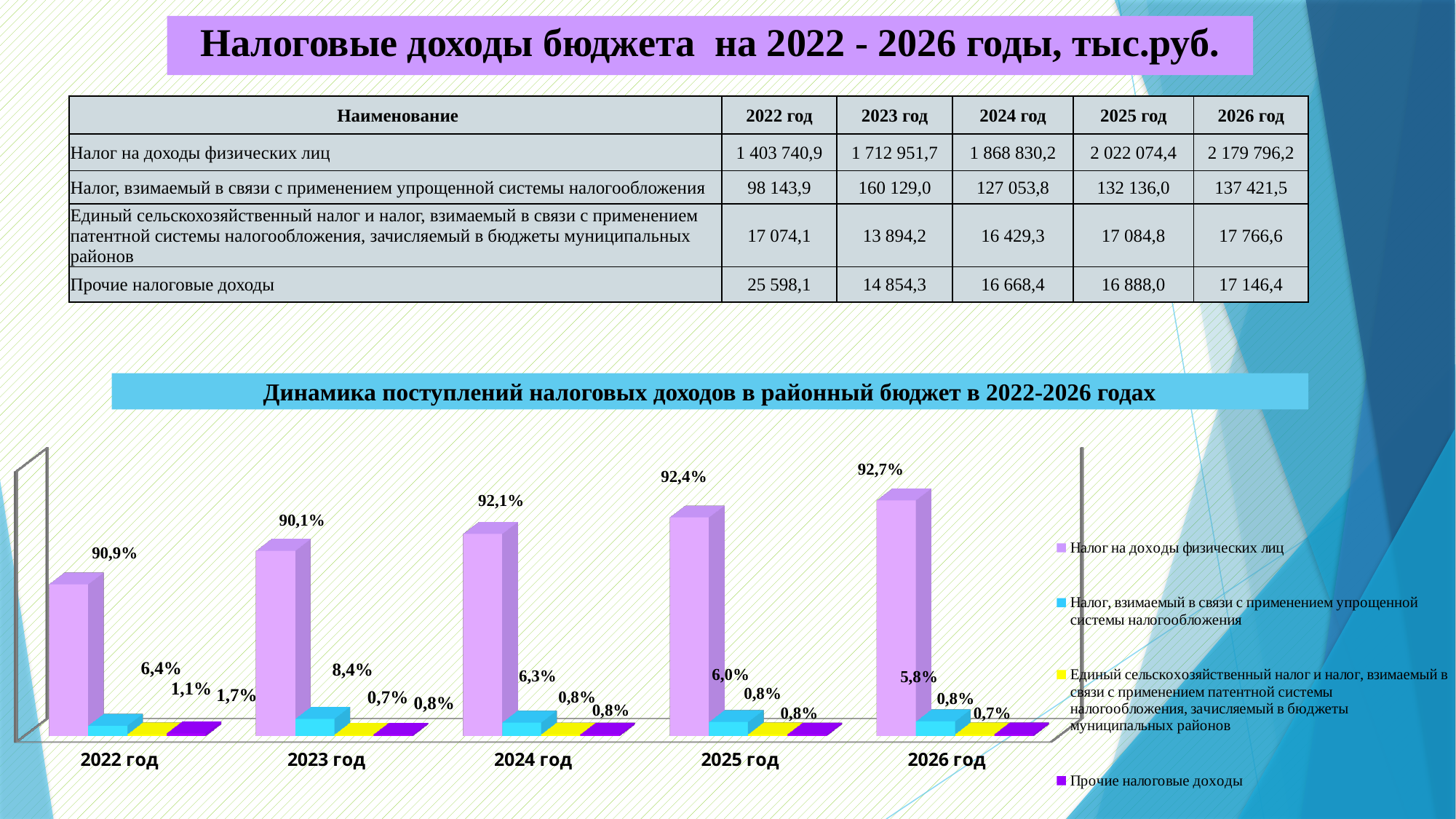
How many year categories are shown on the x axis of the chart? 5 In which year is the value for "Налог на доходы физических лиц" highest on the chart? 2026 год What is the difference between the 2026 год and 2022 год values for "Налог на доходы физических лиц" on the chart? 1,8% What kind of chart is shown under the heading "Динамика поступлений налоговых доходов в районный бюджет в 2022-2026 годах"? Bar chart What is the value for "Прочие налоговые доходы" in 2026 год on the chart? 0,7% How many series does the legend of the chart list? 4 Does the value for "Налог на доходы физических лиц" rise or fall from 2023 год to 2026 год on the chart? Rise What is the value for "Налог на доходы физических лиц" in 2022 год on the chart? 90,9% What is the value for "Налог, взимаемый в связи с применением упрощенной системы налогообложения" in 2023 год on the chart? 8,4% Which is larger on the chart: the 2023 год or the 2024 год value for "Налог, взимаемый в связи с применением упрощенной системы налогообложения"? 2023 год What colour are the bars for "Налог на доходы физических лиц" on the chart? Purple (lilac)